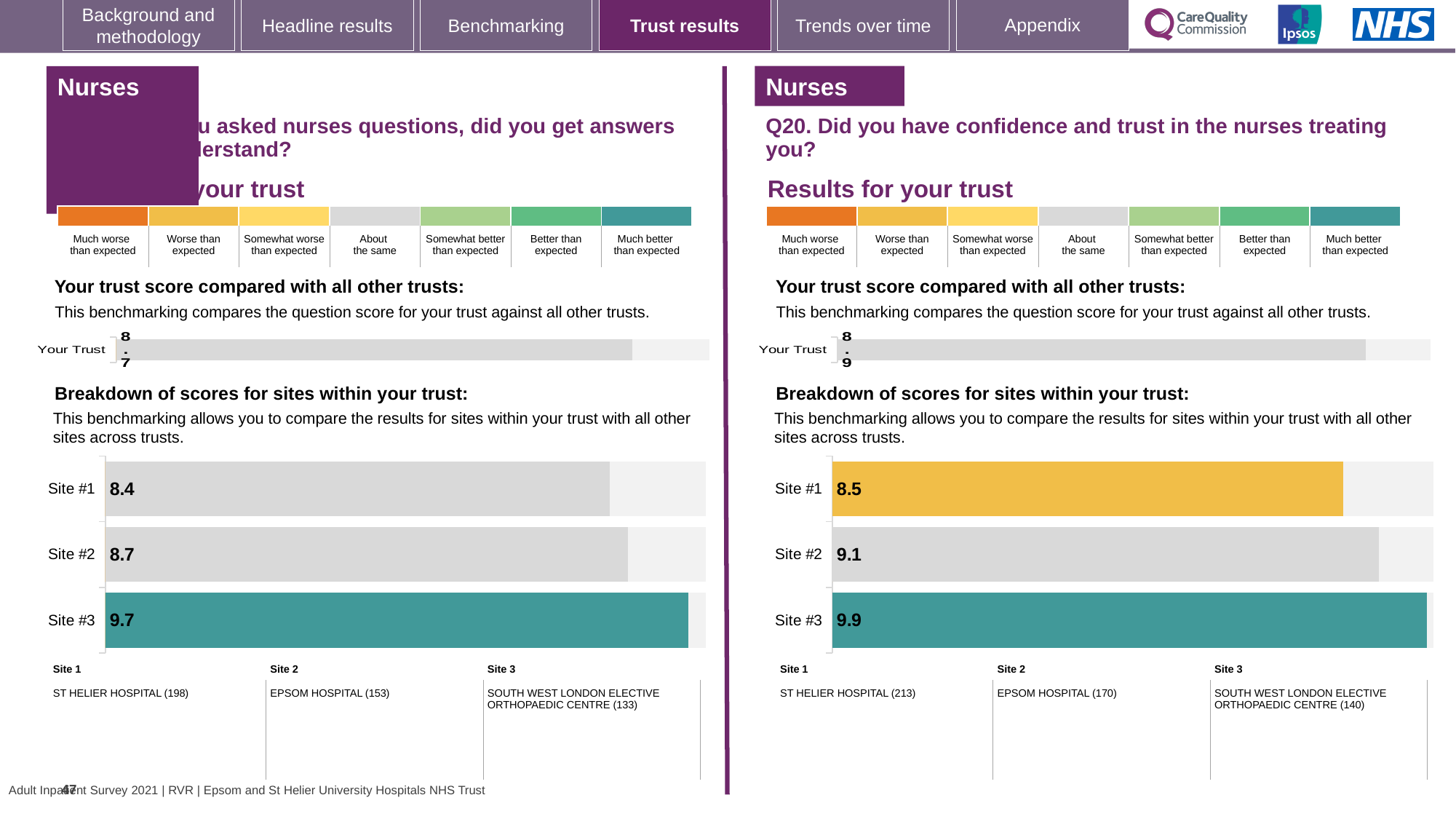
In the site breakdown chart on the right side of the slide (Q20), what is the score for Site #2? 9.1 In the site breakdown chart on the right side of the slide (Q20), what is the difference between the scores for Site #3 and Site #1? 1.4 In the site breakdown chart on the right side of the slide (Q20), what colour is the bar for Site #1? Yellow In the site breakdown chart on the left side of the slide, which site has the lowest score? Site #1 How many sites are shown in the site breakdown chart on the left side of the slide? 3 In the 'Your trust score compared with all other trusts' chart on the right side of the slide (Q20), what is the score for Your Trust? 8.9 In the site breakdown chart on the left side of the slide, what is the score for Site #1? 8.4 In the site breakdown chart on the left side of the slide, what is the score for Site #3? 9.7 In the site breakdown chart on the right side of the slide (Q20), which site has the highest score? Site #3 What type of chart is used for the breakdown of scores for sites on the right side of the slide (Q20)? Bar chart In the site breakdown chart on the right side of the slide (Q20), which has the larger score, Site #1 or Site #2? Site #2 In the site breakdown chart on the left side of the slide, what is the difference between the scores for Site #2 and Site #1? 0.3